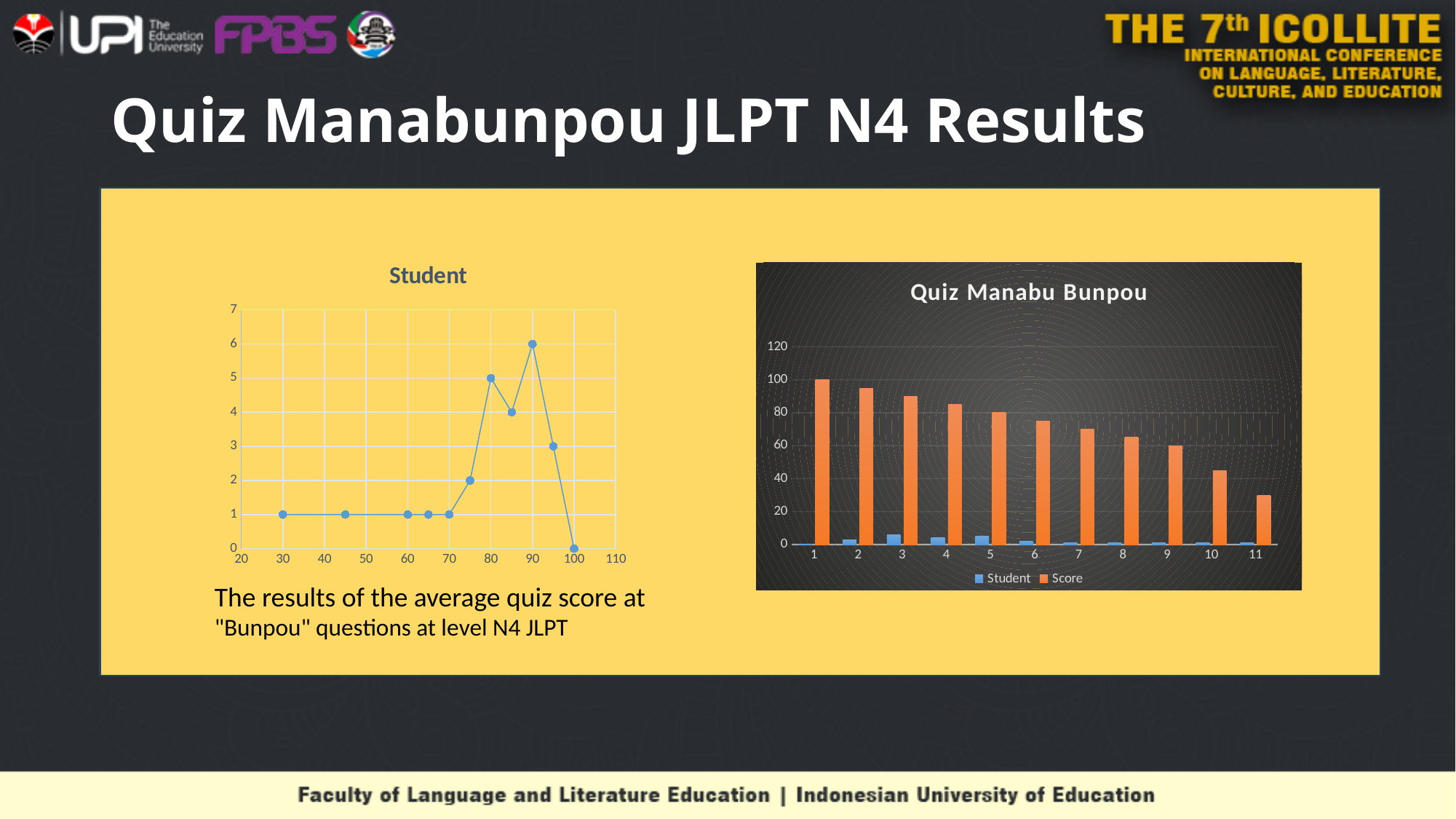
On the right chart titled "Quiz Manabu Bunpou", what kind of chart is it? bar chart On the right chart titled "Quiz Manabu Bunpou", is the Score for category 2 greater or less than 80? greater On the right chart titled "Quiz Manabu Bunpou", which category has the lowest Score? 11 On the right chart titled "Quiz Manabu Bunpou", how many series does the legend list? 2 On the left chart titled "Student", at which x value does the line reach its highest point? 90 On the left chart titled "Student", what is the y value of the point at x = 100? 0 On the right chart titled "Quiz Manabu Bunpou", which is larger, the Score for category 3 or the Score for category 10? category 3 On the right chart titled "Quiz Manabu Bunpou", how many categories are shown on the x axis? 11 On the right chart titled "Quiz Manabu Bunpou", which category has the highest Score? 1 On the left chart titled "Student", how many data points are plotted? 11 On the right chart titled "Quiz Manabu Bunpou", is the Score for category 11 greater or less than 40? less On the right chart titled "Quiz Manabu Bunpou", do the Score values rise or fall from category 1 to category 11? fall